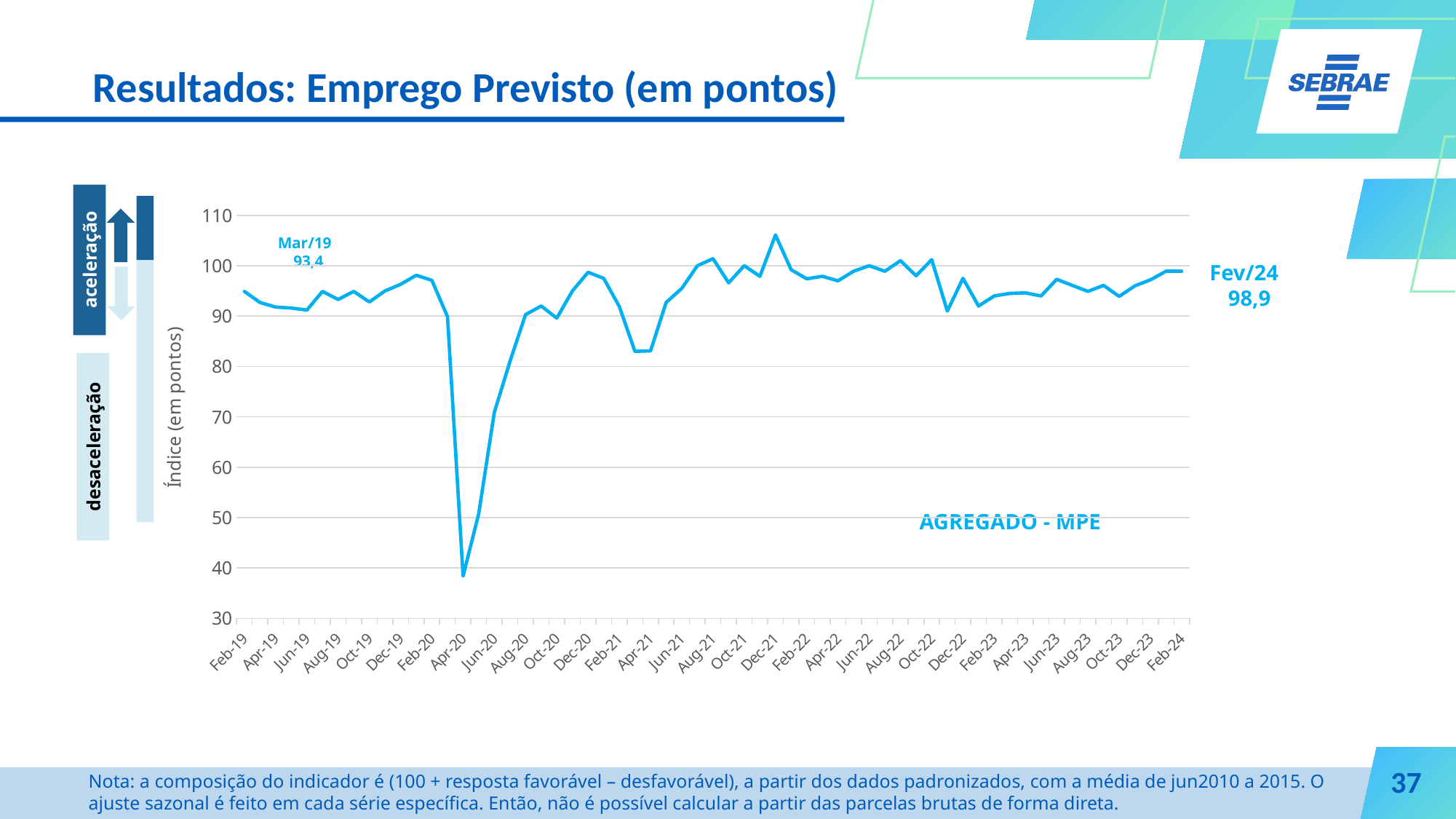
Which labelled value is larger, Mar/19 or Fev/24? Fev/24 Does the line rise or fall between Apr-20 and Jun-20? rise What is the difference between the labelled values for Fev/24 and Mar/19? 5,5 What kind of chart is shown on the slide? line chart Around which month does the line reach its highest point? Dec-21 Is the value at Apr-20 greater or less than 50? less What value is labelled for Fev/24 on the chart? 98,9 Is the value at Dec-21 greater or less than 100? greater Around which month does the line reach its lowest point? Apr-20 What value is labelled for Mar/19 on the chart? 93,4 What is the title of the vertical axis? Índice (em pontos) Is the value at Apr-21 greater or less than 90? less